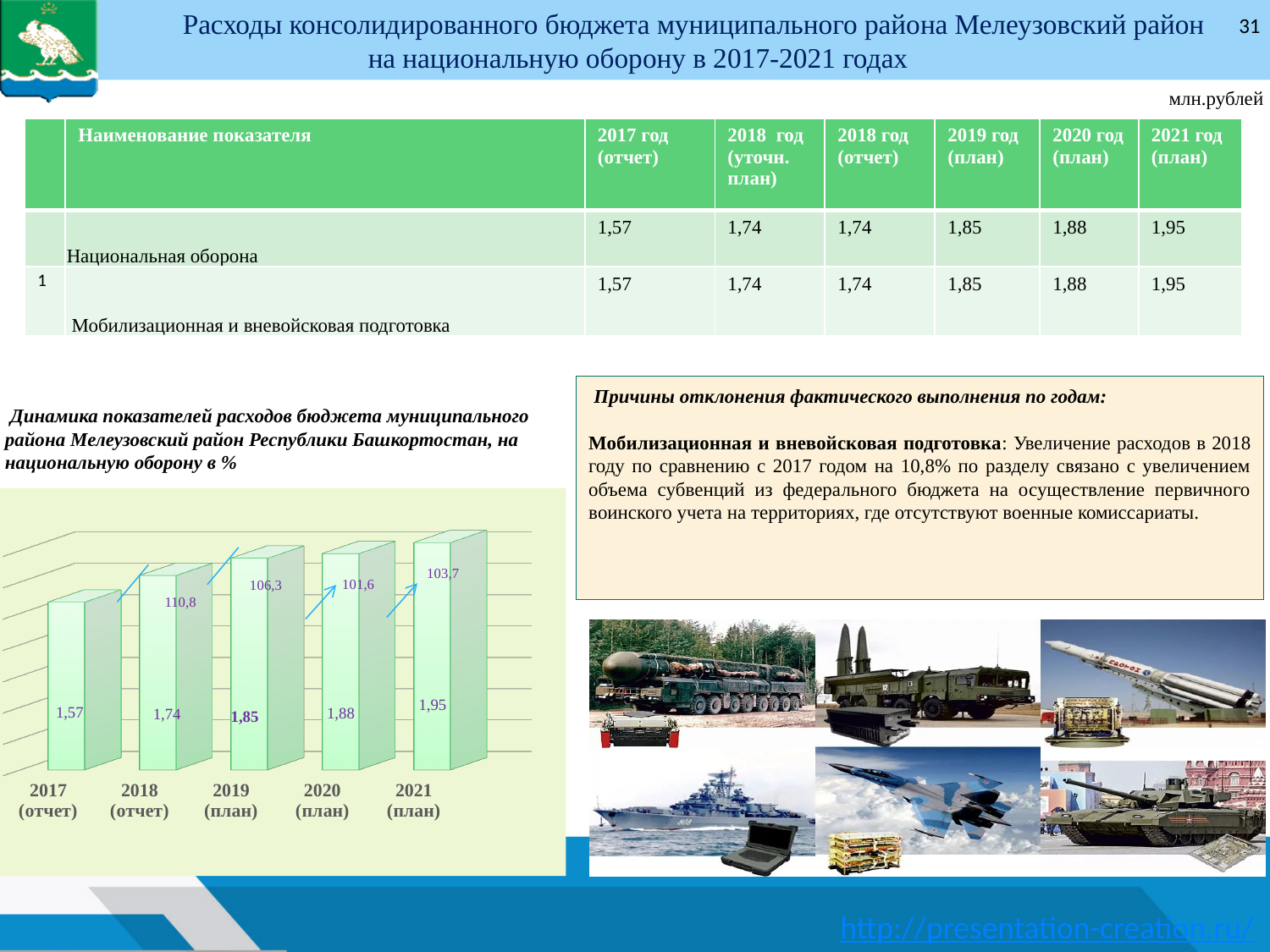
How many bars are shown in the chart? 5 What is the value shown for 2021 (план) in the bar chart? 1,95 What kind of chart is shown on the slide? Bar chart What is the value shown for 2019 (план) in the bar chart? 1,85 Which year has the highest bar in the chart? 2021 (план) What is the value shown for 2017 (отчет) in the bar chart? 1,57 What is the difference between the values for 2021 (план) and 2017 (отчет) in the bar chart? 0,38 What growth percentage is printed between the 2017 and 2018 bars in the chart? 110,8 Do the bar values rise or fall from 2017 to 2021 in the chart? Rise Which is larger in the bar chart: the value for 2020 (план) or the value for 2018 (отчет)? 2020 (план) What is the difference between the values for 2018 (отчет) and 2017 (отчет) in the bar chart? 0,17 Which year has the lowest bar in the chart? 2017 (отчет)